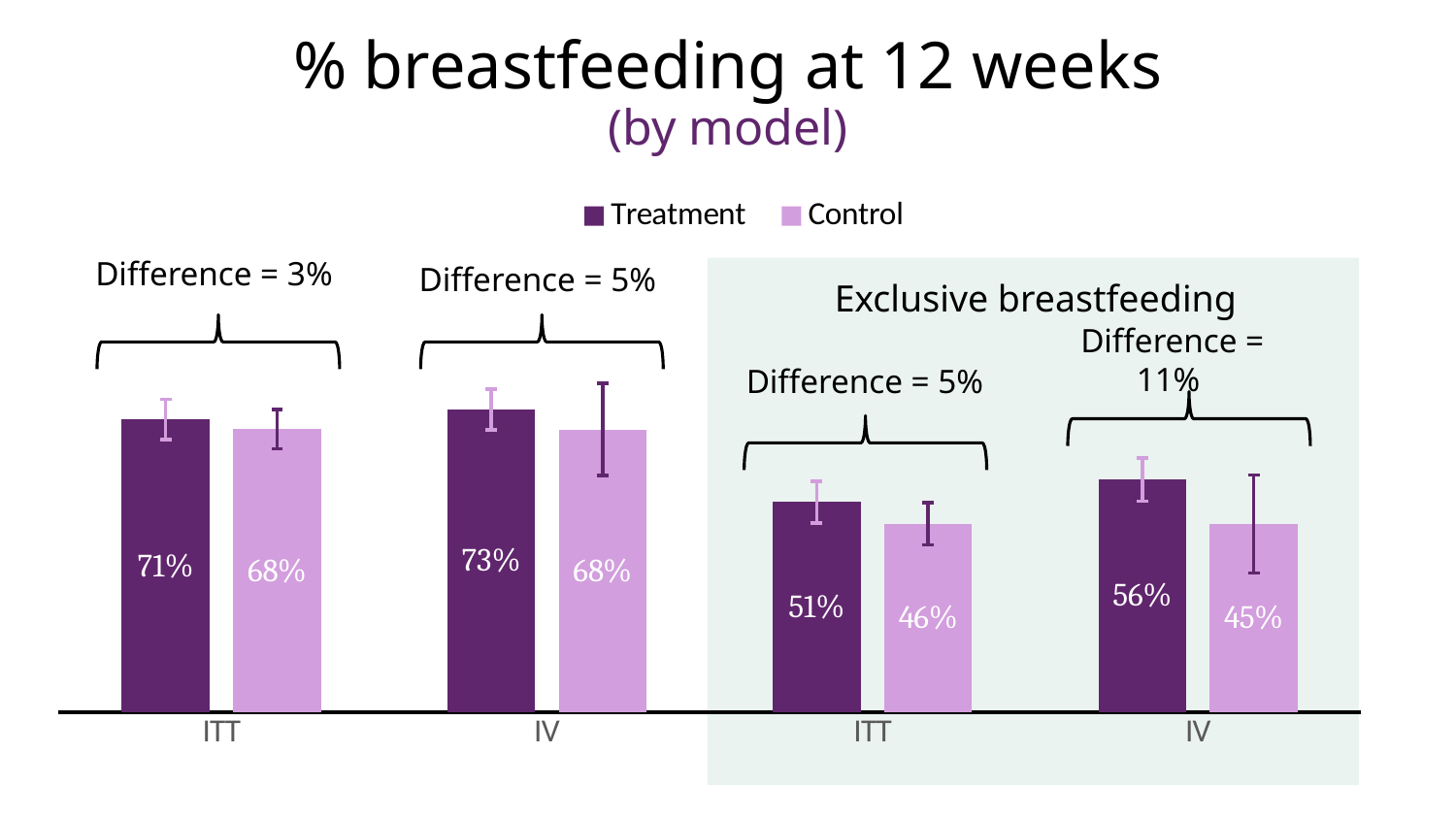
What is the Control value for the first IV group (left, outside the Exclusive breastfeeding box)? 68% What kind of chart is shown on the slide? Bar chart What is the Control value for the IV group in the Exclusive breastfeeding section? 45% Which bar has the lowest value on the chart? Control, IV in Exclusive breastfeeding (45%) Which is larger for the first ITT group: Treatment or Control? Treatment What is the Treatment value for the first ITT group (left, outside the Exclusive breastfeeding box)? 71% What is the Treatment value for the ITT group in the Exclusive breastfeeding section? 51% How many category groups are shown along the x axis? 4 What is the title of the chart? % breastfeeding at 12 weeks (by model) Which bar has the highest value on the chart? Treatment, IV (73%) How many series does the legend list? 2 What is the difference between Treatment and Control for the IV group in the Exclusive breastfeeding section? 11%